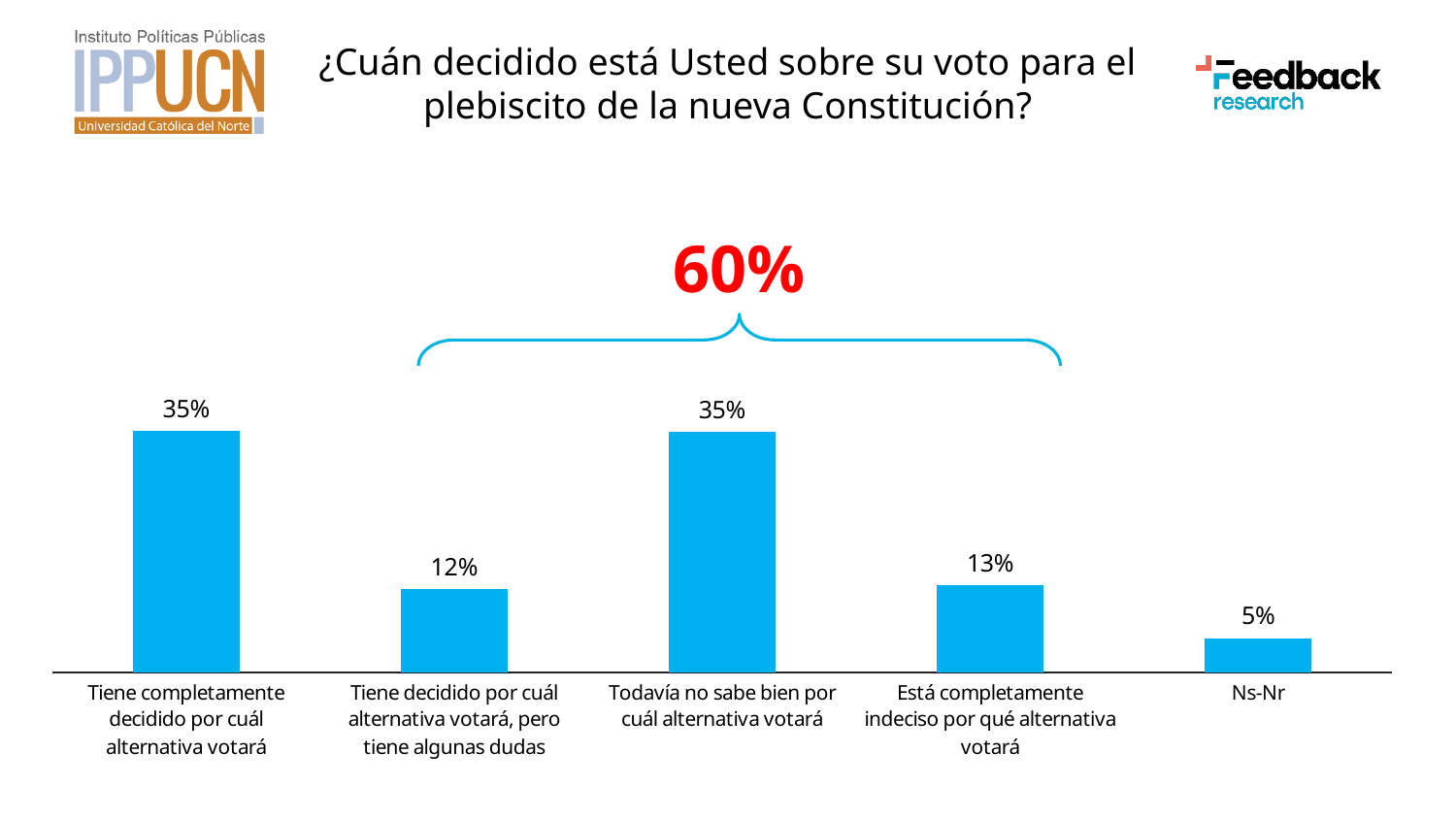
What is the difference between the value for "Tiene completamente decidido por cuál alternativa votará" and the value for "Ns-Nr"? 30% What type of chart is shown on the slide? Bar chart What is the difference between the values for "Está completamente indeciso por qué alternativa votará" and "Tiene decidido por cuál alternativa votará, pero tiene algunas dudas"? 1% Which category has the lowest value in the chart? Ns-Nr What is the value for "Está completamente indeciso por qué alternativa votará"? 13% Which is larger: the value for "Está completamente indeciso por qué alternativa votará" or the value for "Ns-Nr"? Está completamente indeciso por qué alternativa votará What percentage of respondents said they have completely decided which alternative they will vote for ("Tiene completamente decidido por cuál alternativa votará")? 35% What percentage is printed in red above the bracket spanning the three middle bars? 60% What percentage is shown for "Todavía no sabe bien por cuál alternativa votará"? 35% How many categories are shown in the chart? 5 What percentage is shown for the "Ns-Nr" category? 5% What is the value shown for "Tiene decidido por cuál alternativa votará, pero tiene algunas dudas"? 12%